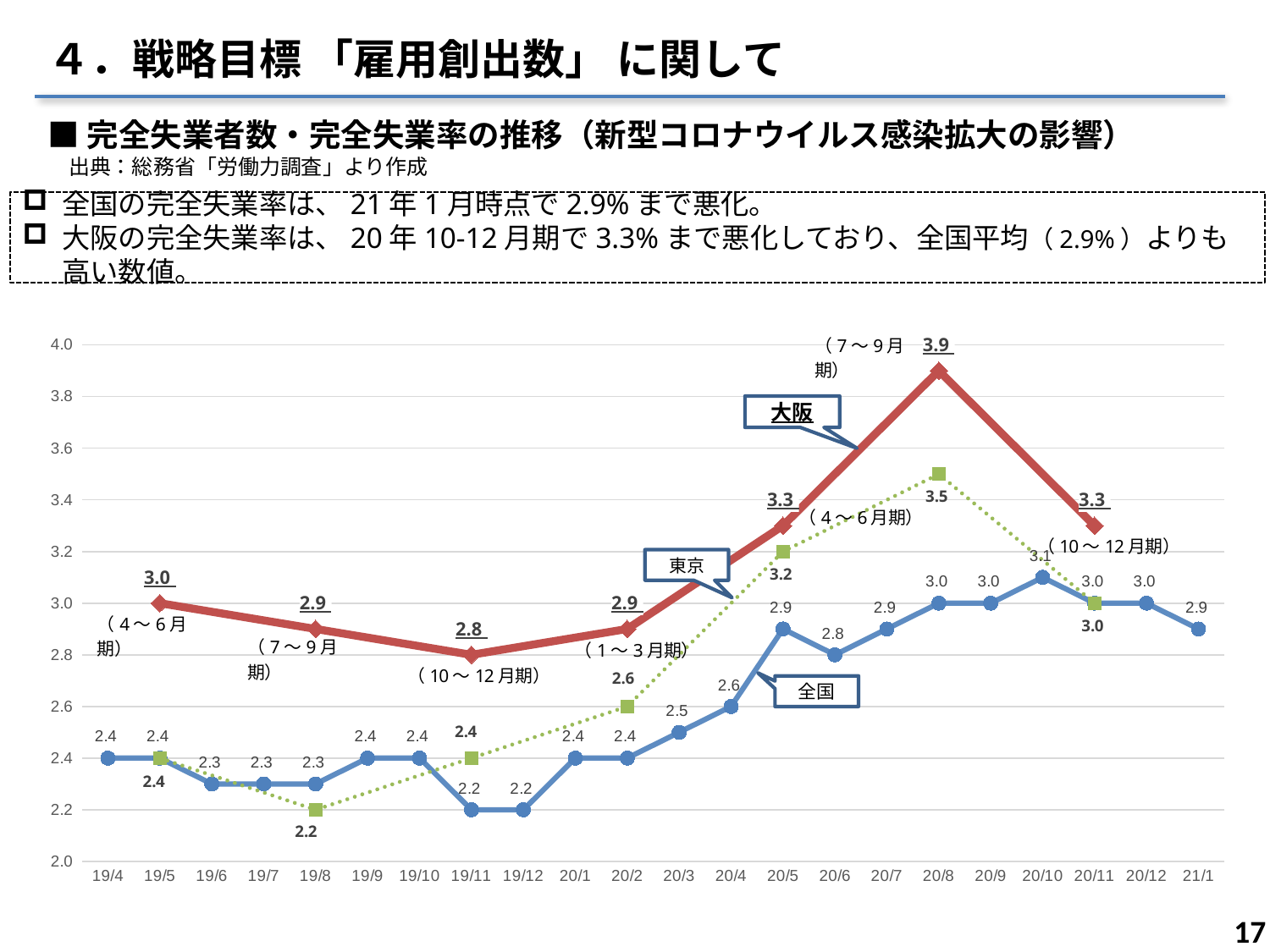
How many series are plotted on the chart? 3 What is the value for 東京 at 20/5? 3.2 Does the 全国 series rise or fall from 20/2 to 20/5? rise Which series is drawn with the red line? 大阪 What kind of chart is shown on the slide? line chart What is the difference between the 大阪 value and the 全国 value at 20/8? 0.9 What is the value for 全国 at 21/1? 2.9 What is the value for 大阪 at 20/8? 3.9 At 20/11, which series has the larger value, 大阪 or 東京? 大阪 How many x-axis points are shown on the chart? 22 At which x-axis point does the 大阪 series reach its highest value? 20/8 What is the lowest value plotted for the 全国 series? 2.2